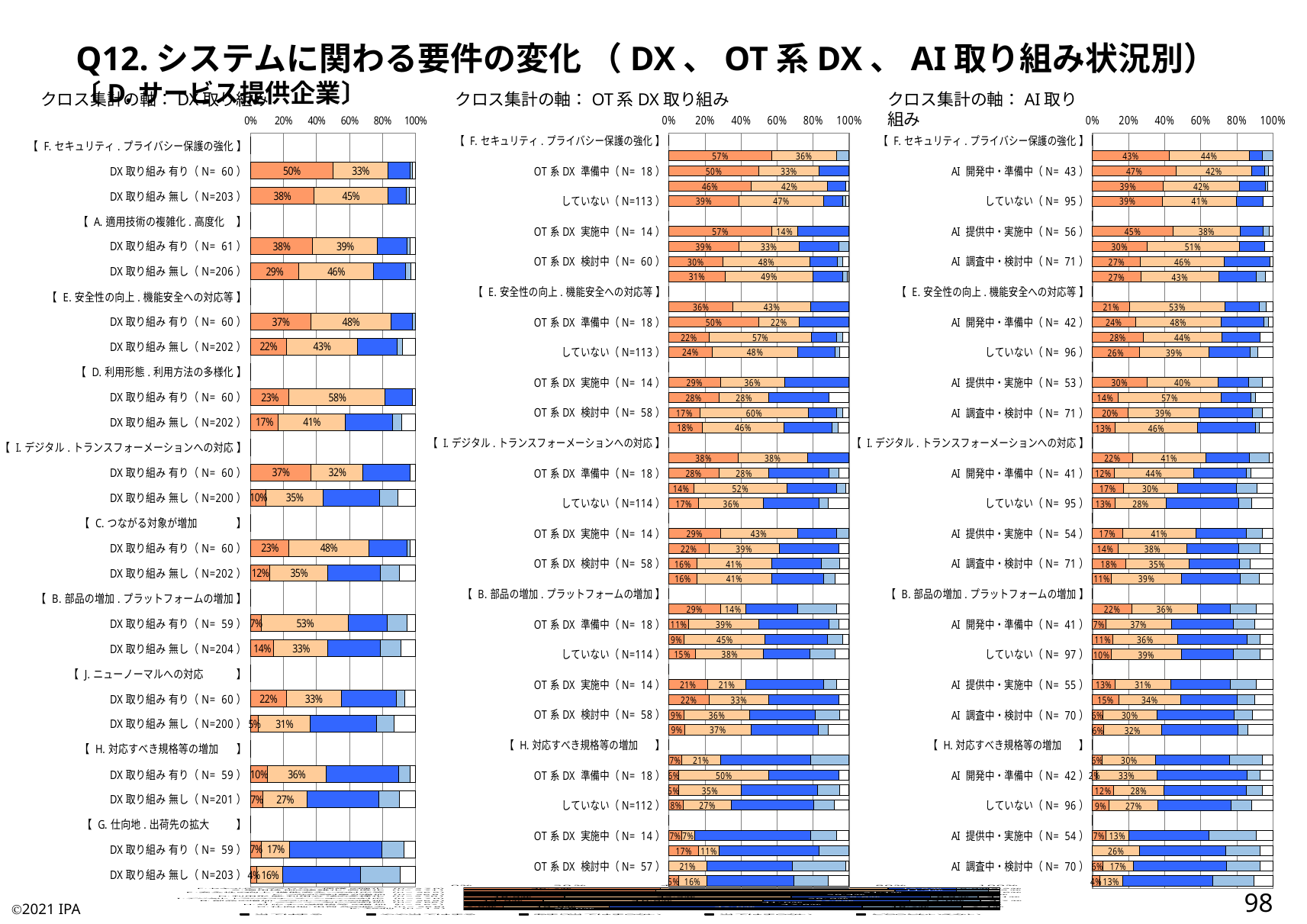
In the left chart (クロス集計の軸：DX取り組み), under 'F. セキュリティ.プライバシー保護の強化', how many percentage points larger is the first (orange) segment for 'DX取り組み有り（N=60）' (50%) than for 'DX取り組み無し（N=203）' (38%)? 12 percentage points In the left chart (クロス集計の軸：DX取り組み), what is the value printed on the first (orange) segment of the bar for 'DX取り組み無し（N=203）' under 'G. 仕向地.出荷先の拡大'? 4% In the left chart (クロス集計の軸：DX取り組み), which requirement category has the highest first (orange) segment value for the 'DX取り組み有り' rows? F. セキュリティ.プライバシー保護の強化 In the left chart (クロス集計の軸：DX取り組み), under 'E. 安全性の向上.機能安全への対応等', which row has the larger first (orange) segment: 'DX取り組み有り（N=60）' or 'DX取り組み無し（N=202）'? DX取り組み有り（N=60） In the left chart (クロス集計の軸：DX取り組み), what is the value printed on the first (orange) segment of the bar for 'DX取り組み有り（N=60）' under 'F. セキュリティ.プライバシー保護の強化'? 50% How many charts are shown on the slide? 3 In the middle chart (クロス集計の軸：OT系DX取り組み), what is the value printed on the first (orange) segment of the bar for 'OT系DX 準備中（N=18）' under 'F. セキュリティ.プライバシー保護の強化'? 50% What is the cross-tabulation axis (クロス集計の軸) stated above the right-hand chart? AI取り組み What kind of chart is used on this slide? Horizontal stacked bar chart In the left chart (クロス集計の軸：DX取り組み), what is the value printed on the second (light orange) segment of the bar for 'DX取り組み無し（N=203）' under 'F. セキュリティ.プライバシー保護の強化'? 45% In the left chart (クロス集計の軸：DX取り組み), what is the value printed on the second (light orange) segment of the bar for 'DX取り組み有り（N=60）' under 'D. 利用形態.利用方法の多様化'? 58% In the right chart (クロス集計の軸：AI取り組み), what is the value printed on the first (orange) segment of the bar for 'AI 開発中・準備中（N=43）' under 'F. セキュリティ.プライバシー保護の強化'? 47%